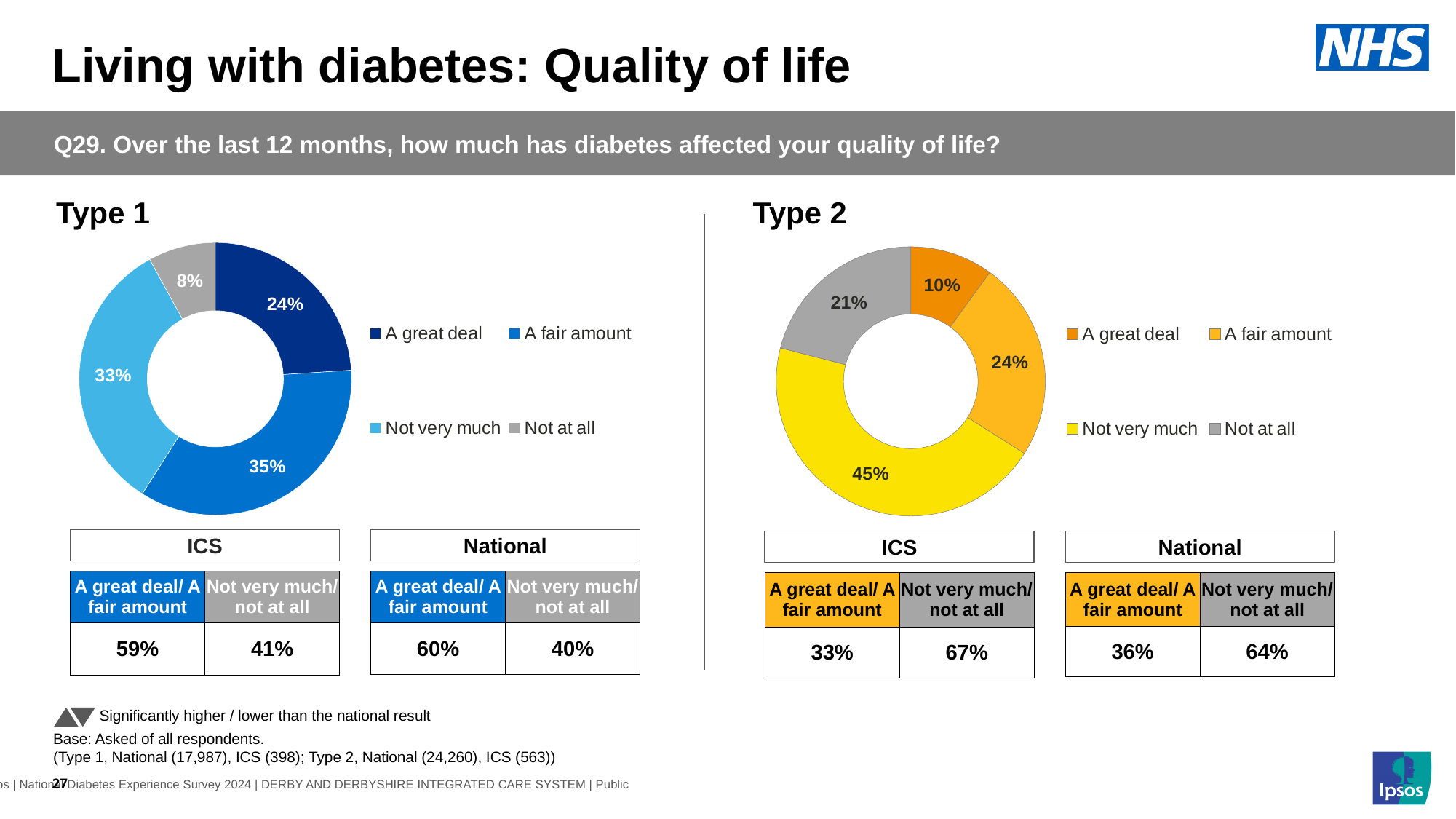
In the Type 2 chart, what is the combined share of 'Not very much' and 'Not at all'? 66% In the Type 1 chart, what is the difference between the 'Not very much' and 'Not at all' shares? 25 percentage points In the Type 2 chart, which is larger: 'A fair amount' or 'Not at all'? A fair amount In the Type 2 chart, which category has the smallest share? A great deal How many categories does the Type 2 chart show? 4 What type of chart is used for Type 1? Doughnut chart In the Type 1 chart, what percentage said 'Not at all'? 8% In the Type 1 chart, which category has the largest share? A fair amount In the Type 1 chart, what is the combined share of 'A great deal' and 'A fair amount'? 59% In the Type 1 chart, what percentage of respondents said diabetes affected their quality of life 'A great deal'? 24% In the Type 2 chart, what percentage of respondents said 'Not very much'? 45% What colour represents 'Not very much' in the Type 2 chart? Yellow